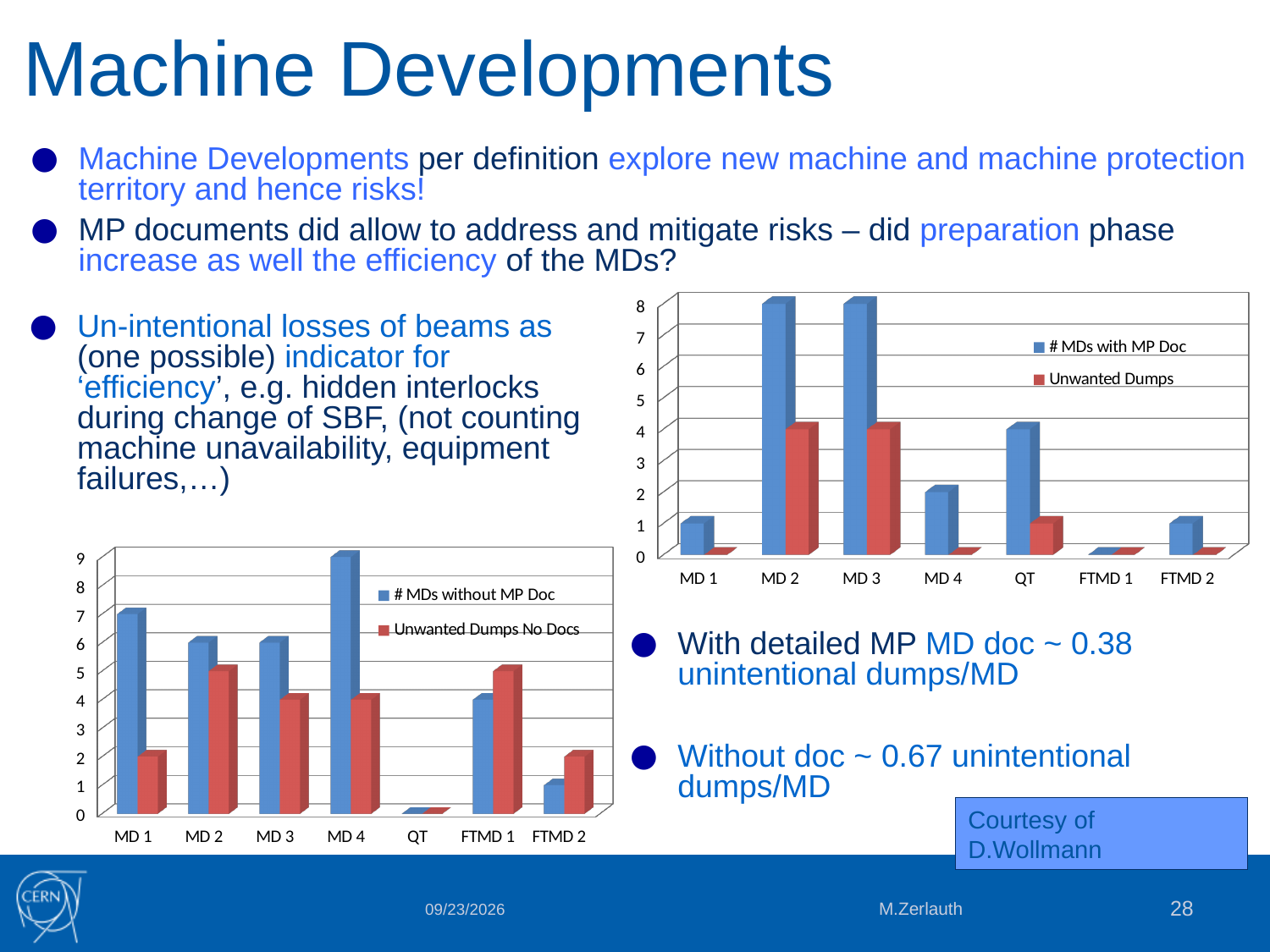
In the top-right chart, is the value of 'Unwanted Dumps' for MD 2 greater or less than 3? greater In the top-right chart, what is the value of '# MDs with MP Doc' for QT? 4 In the bottom-left chart, what is the value of '# MDs without MP Doc' for MD 1? 7 In the top-right chart, which category has the highest value for '# MDs with MP Doc'? MD 2 and MD 3 In the top-right chart, how many series does the legend list? 2 In the bottom-left chart, which is larger for FTMD 1: '# MDs without MP Doc' or 'Unwanted Dumps No Docs'? Unwanted Dumps No Docs In the bottom-left chart, is the value of '# MDs without MP Doc' for MD 4 greater or less than 8? greater In the top-right chart, what colour represents 'Unwanted Dumps'? Red In the bottom-left chart, what are the two legend entries? # MDs without MP Doc; Unwanted Dumps No Docs In the bottom-left chart, which category has the highest value for '# MDs without MP Doc'? MD 4 What type of chart is the bottom-left chart? Bar chart In the top-right chart, how many categories are shown on the x axis? 7